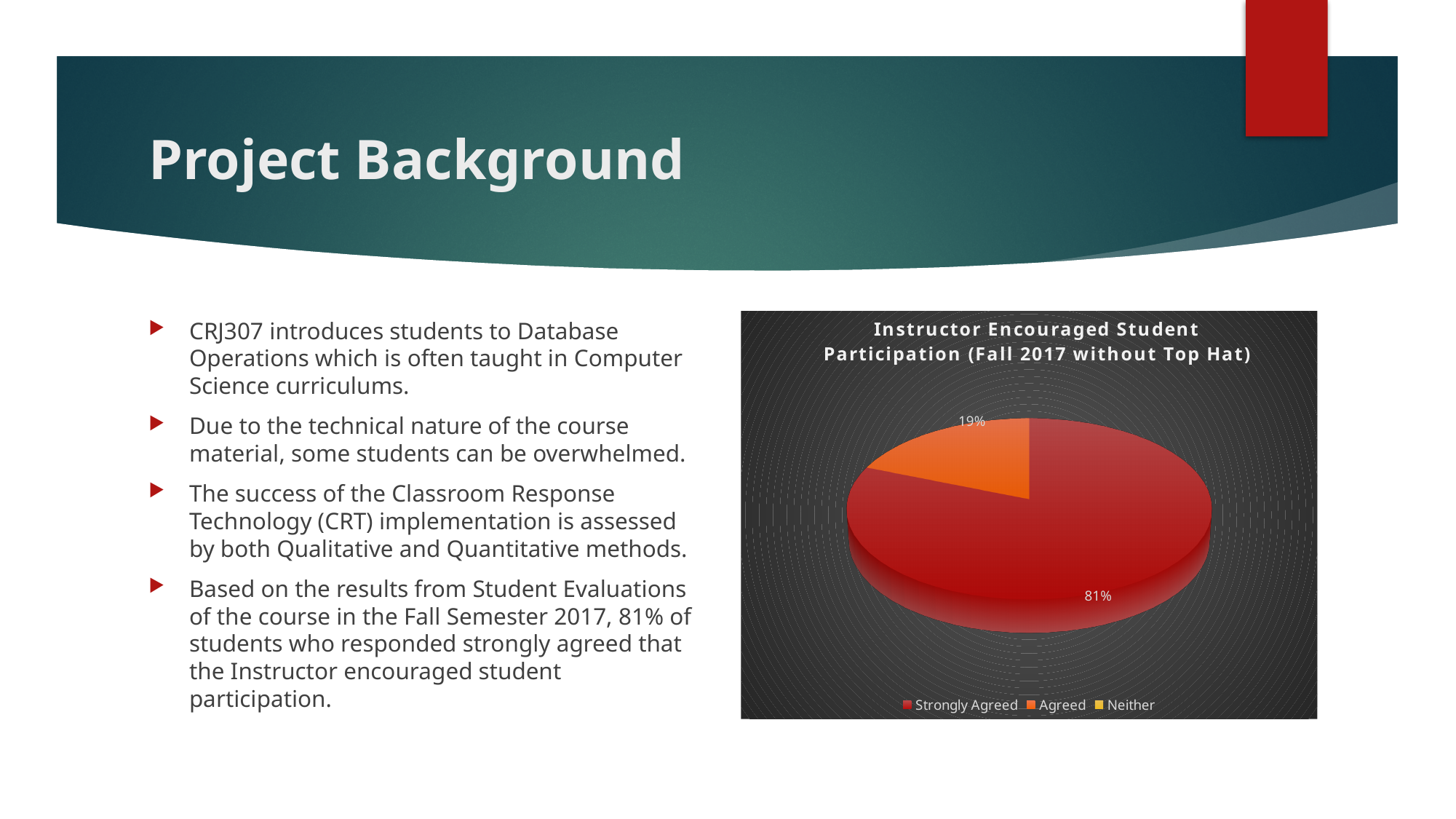
What is the difference in percentage points between the Strongly Agreed slice and the Agreed slice? 62 percentage points What colour is used for the Agreed slice? Orange What percentage of the pie is labelled for Agreed? 19% What is the title of the chart? Instructor Encouraged Student Participation (Fall 2017 without Top Hat) What share of the pie does the Strongly Agreed slice represent? 81% How many categories does the legend list? 3 Is the Agreed slice greater or less than 50% of the pie? less Which category has the largest slice of the pie? Strongly Agreed What type of chart is shown on the slide? Pie chart What percentage of the pie is labelled for Strongly Agreed? 81% Which is larger, the Strongly Agreed slice or the Agreed slice? Strongly Agreed